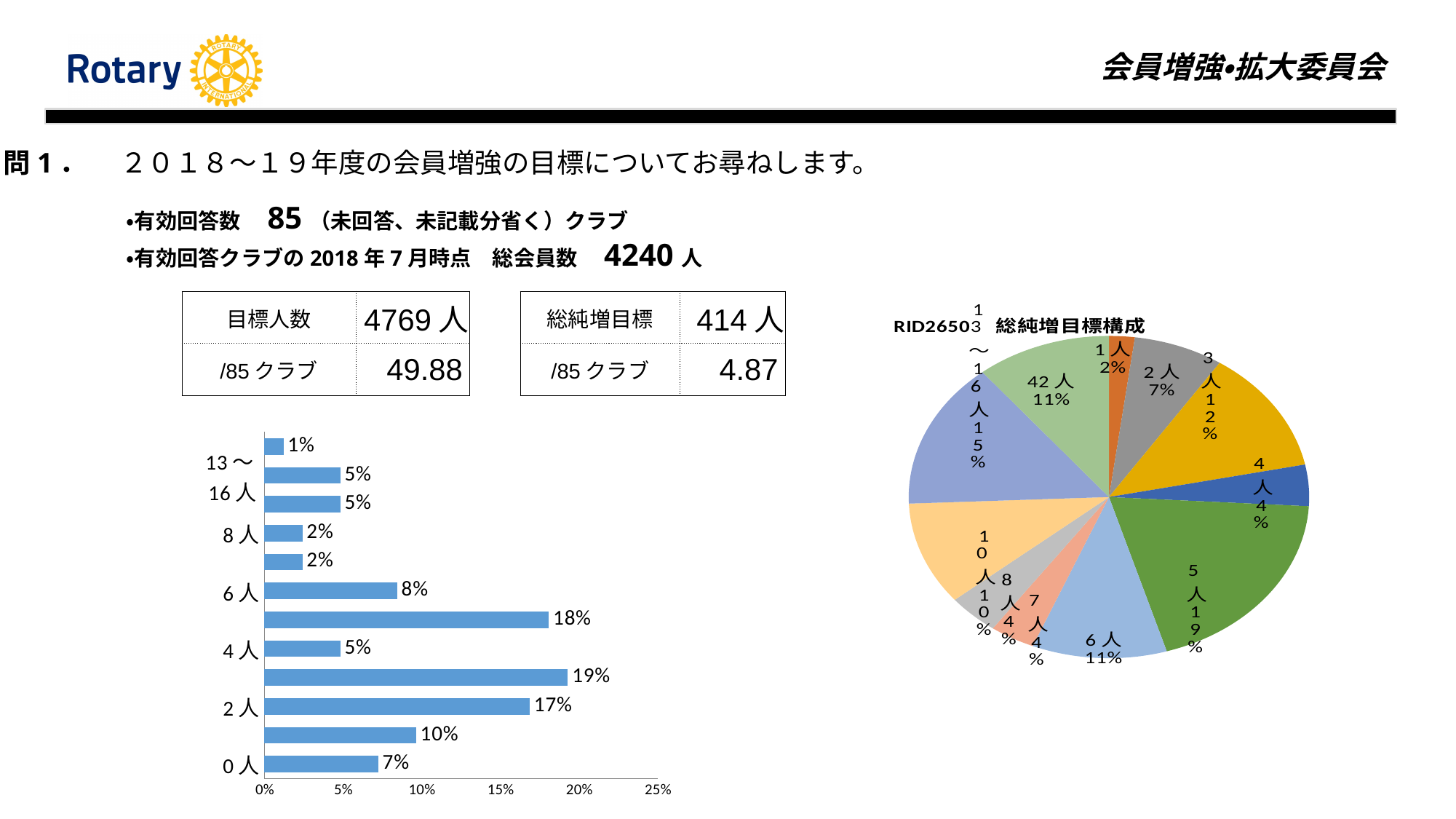
In the pie chart RID2650 総純増目標構成, what share does the 5人 slice have? 19% What type of chart is the chart titled RID2650 総純増目標構成? pie chart In the pie chart RID2650 総純増目標構成, what share does the 42人 slice have? 11% In the bar chart on the left, what is the value for 6人? 8% In the pie chart RID2650 総純増目標構成, which slice is the smallest? 1人 In the bar chart on the left, which is larger, the value for 2人 or the value for 4人? 2人 In the bar chart on the left, what is the value for 2人? 17% What type of chart is the chart on the left of the slide? bar chart In the bar chart on the left, what is the highest value shown on any bar? 19% In the bar chart on the left, what is the difference between the value for 2人 and the value for 0人? 10% In the bar chart on the left, what is the value for 0人? 7% In the bar chart on the left, how many bars are plotted? 12